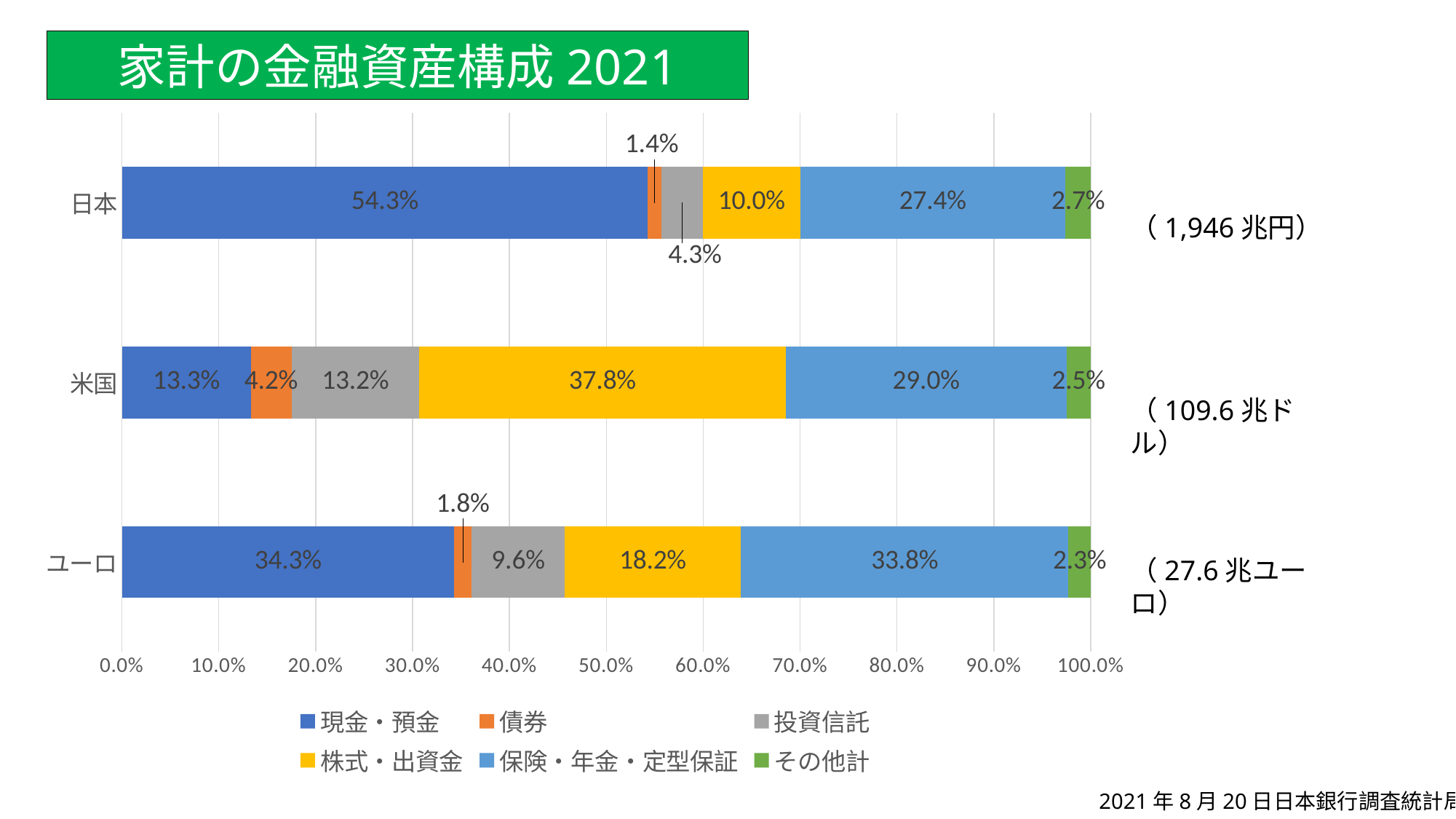
What is the 現金・預金 share for 日本? 54.3% What is the 保険・年金・定型保証 share for ユーロ? 33.8% What type of chart is shown on the slide? Stacked bar chart What is the difference between the 現金・預金 share of 日本 and that of 米国? 41.0% Which region has the lowest 株式・出資金 share? 日本 What is the 債券 share for ユーロ? 1.8% What is the title of the chart on the slide? 家計の金融資産構成 2021 Which is larger, the 投資信託 share for 米国 or for ユーロ? 米国 How many series does the legend list? 6 Which region has the highest 現金・預金 share? 日本 How many regions (categories) are shown in the chart? 3 What is the 株式・出資金 share for 米国? 37.8%